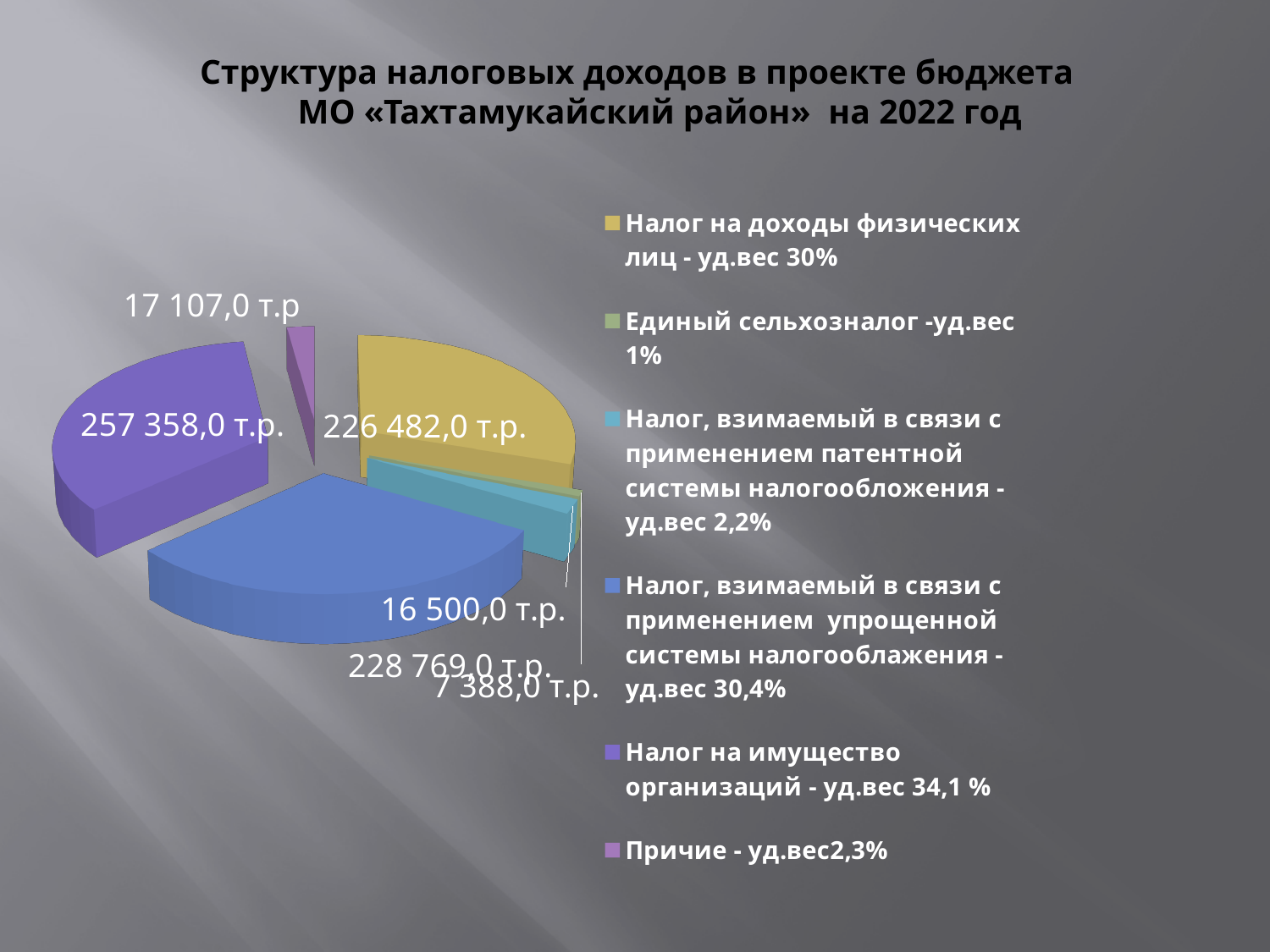
Which is larger: the value for Налог на имущество организаций or the value for Налог на доходы физических лиц? Налог на имущество организаций What is the difference between the value for Налог на имущество организаций and the value for Налог на доходы физических лиц? 30 876,0 т.р. What is the value shown for Налог на имущество организаций? 257 358,0 т.р. How many slices does the pie chart have? 6 What kind of chart is shown on the slide? pie chart What is the value shown for the tax under the patent system (патентной системы налогообложения)? 16 500,0 т.р. What is the value shown for Единый сельхозналог? 7 388,0 т.р. What is the value shown for Налог на доходы физических лиц? 226 482,0 т.р. What share of the pie does Налог на имущество организаций have according to the legend? 34,1 % What share of the pie does Причие have according to the legend? 2,3% Which category has the smallest slice of the pie? Единый сельхозналог Which category has the largest slice of the pie? Налог на имущество организаций